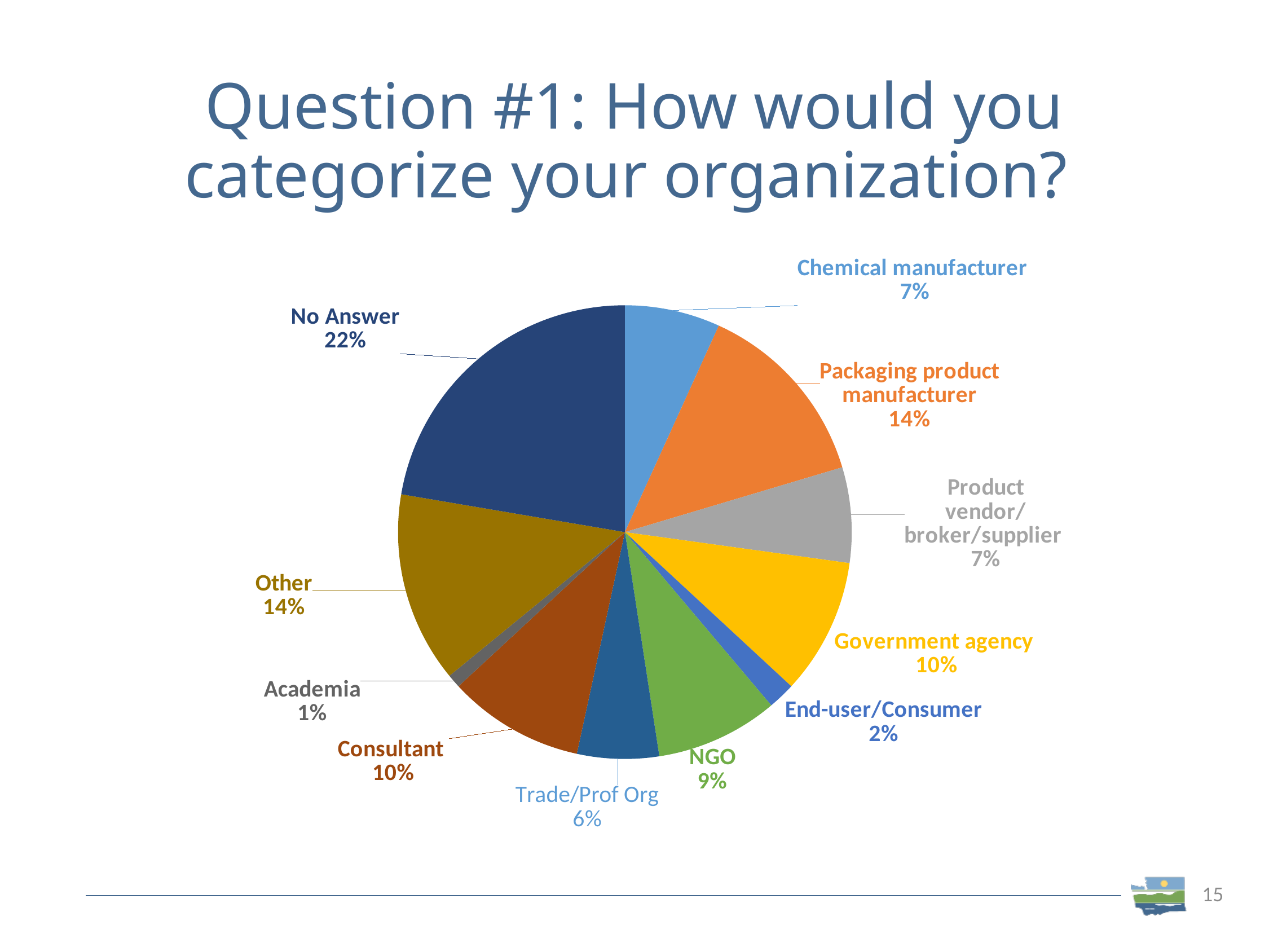
What is the difference between the Consultant share and the Chemical manufacturer share? 3% What type of chart is shown on the slide? pie chart What is the difference between the No Answer share and the Other share? 8% Which category has the smallest slice of the pie? Academia What share of the pie does No Answer represent? 22% What is the value for Government agency? 10% What is the value for Trade/Prof Org? 6% How many categories are shown in the pie chart? 11 What is the title of the slide containing the pie chart? Question #1: How would you categorize your organization? What is the value for Packaging product manufacturer? 14% Which category has the largest slice of the pie? No Answer Which is larger, the NGO slice or the End-user/Consumer slice? NGO